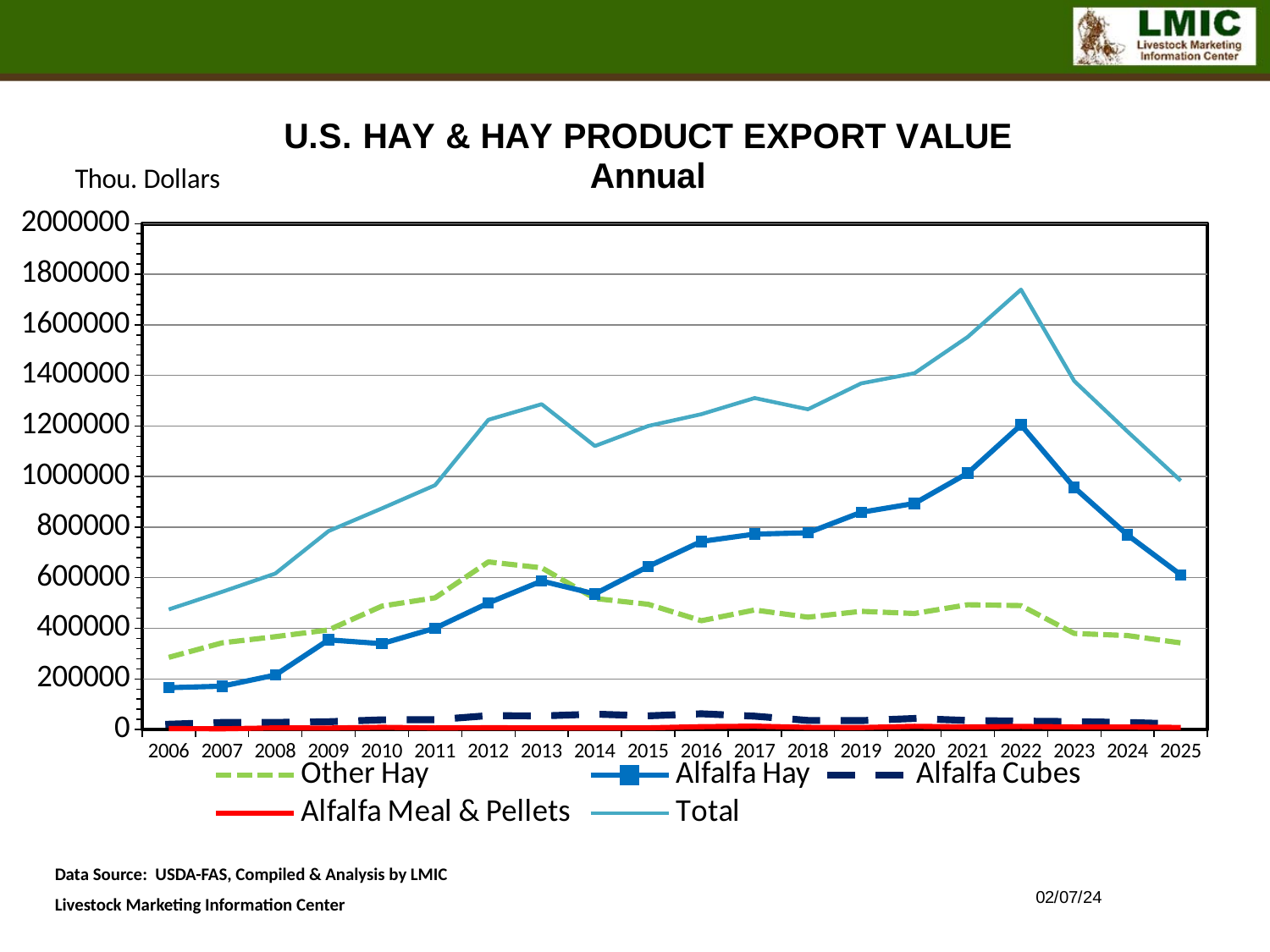
How many series does the legend list? 5 Is the Other Hay value for 2012 greater or less than 600000? greater What unit is shown for the y axis? Thou. Dollars In 2006, which is larger: Other Hay or Alfalfa Hay? Other Hay Is the Total value for 2022 greater or less than 1600000? greater Does the Total series rise or fall from 2022 to 2025? fall In which year does the Total series reach its highest value? 2022 What kind of chart is shown on the slide? line chart In which year does the Alfalfa Hay series reach its highest value? 2022 In which year is the Total series at its lowest value? 2006 Is the Alfalfa Hay value for 2025 greater or less than 800000? less How many years are plotted along the x axis? 20